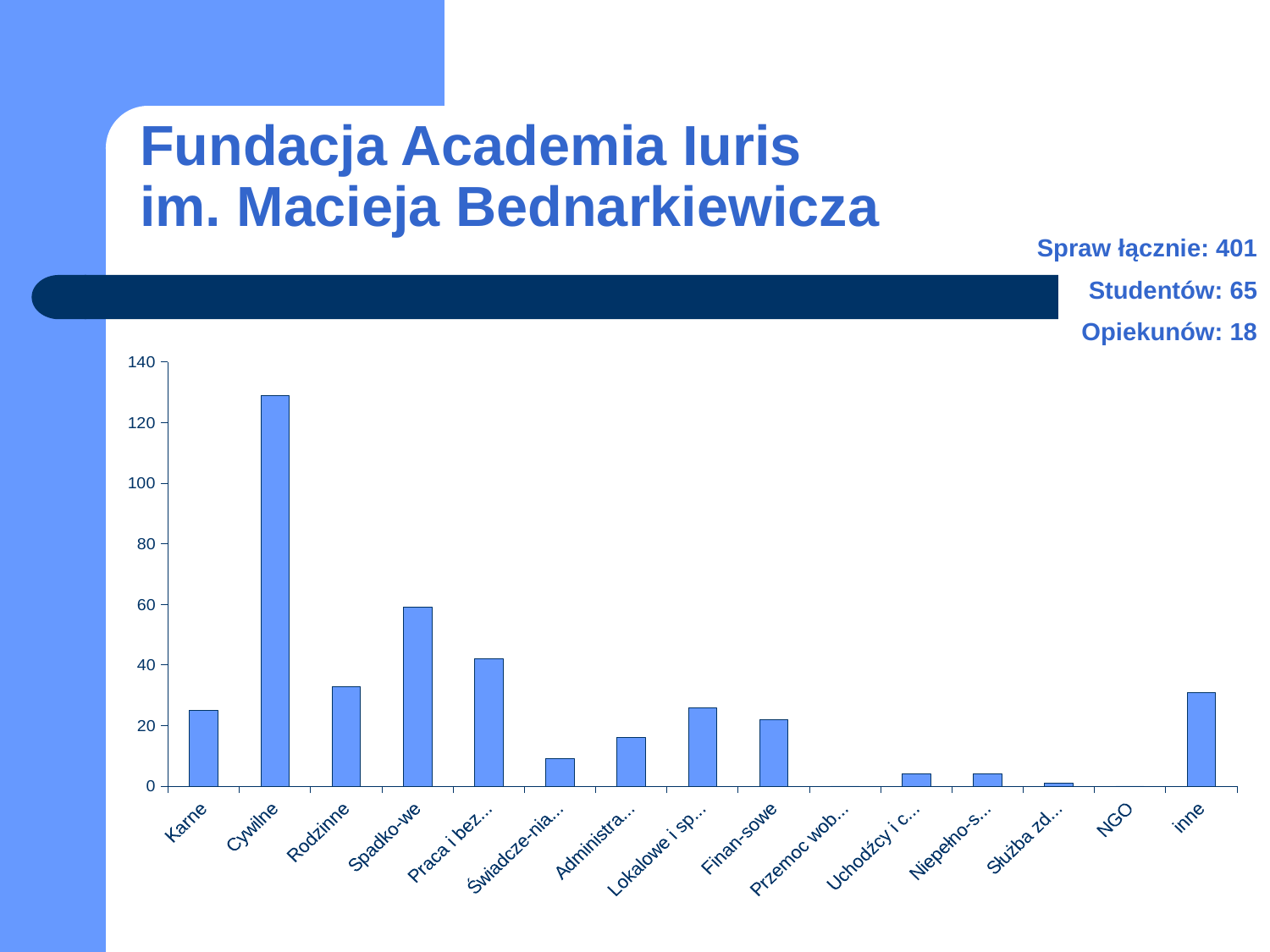
Which category has the highest bar in the chart? Cywilne How many categories are shown on the x axis of the chart? 15 Is the value for inne greater or less than 20? greater Is the value for Cywilne greater or less than 120? greater Is the value for Karne greater or less than 20? greater What kind of chart is shown on the slide? bar chart What colour are the bars in the chart? blue Which is larger, the value for Administra... or the value for Świadcze-nia...? Administra... Which is larger, the value for Spadko-we or the value for Praca i bez...? Spadko-we